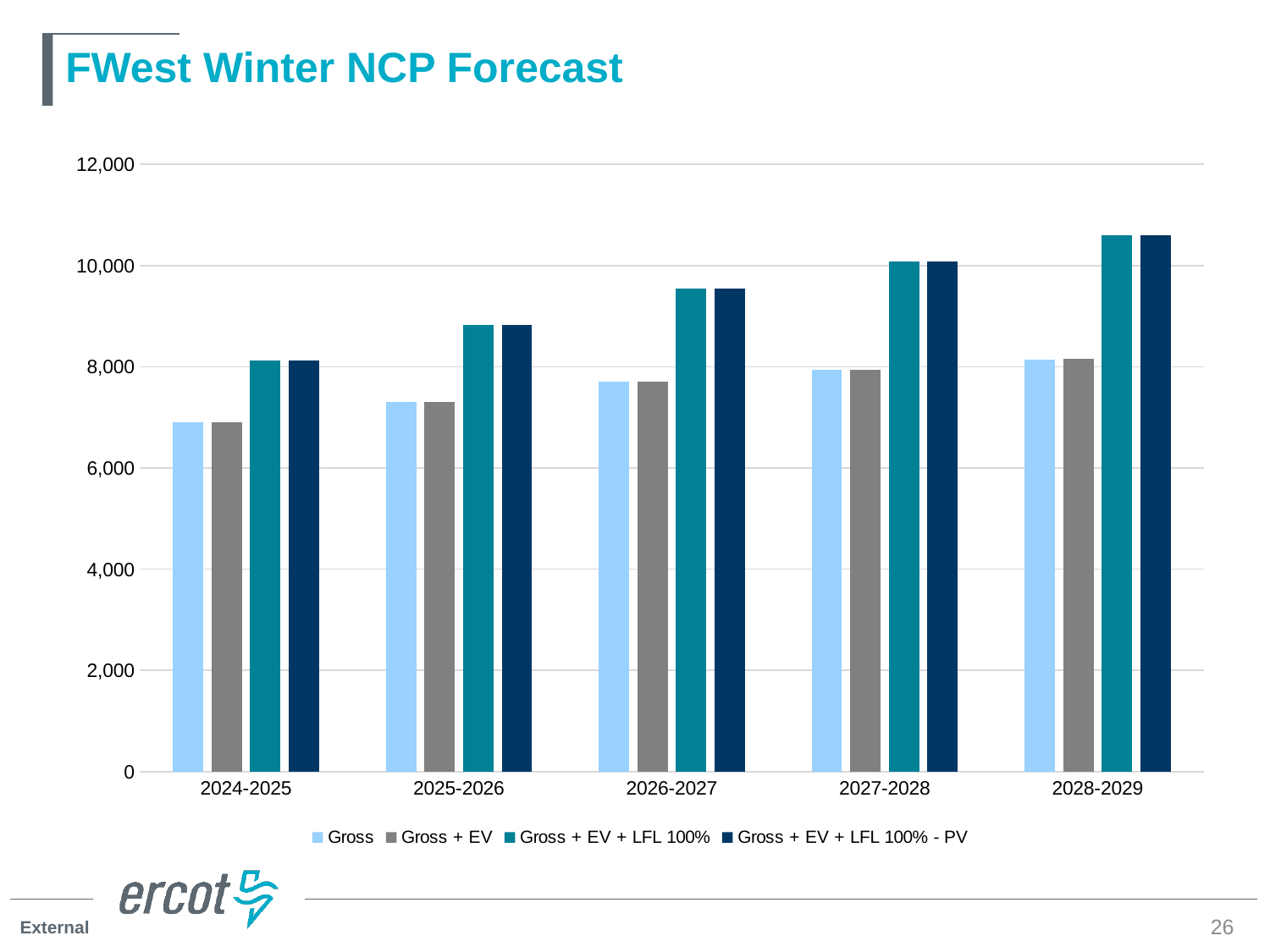
Is the value for Gross + EV + LFL 100% in 2026-2027 greater or less than 10,000? less What kind of chart is shown on the slide? bar chart How many series does the legend list? 4 Is the value for Gross in 2024-2025 greater or less than 8,000? less Do the Gross values rise or fall from 2024-2025 to 2028-2029? rise Is the value for Gross + EV in 2025-2026 greater or less than 8,000? less In which winter season is the Gross + EV + LFL 100% value highest? 2028-2029 In 2026-2027, which is larger: Gross or Gross + EV + LFL 100%? Gross + EV + LFL 100% In which winter season is the Gross value lowest? 2024-2025 What is the title of the chart? FWest Winter NCP Forecast How many winter seasons (categories) are shown on the x axis? 5